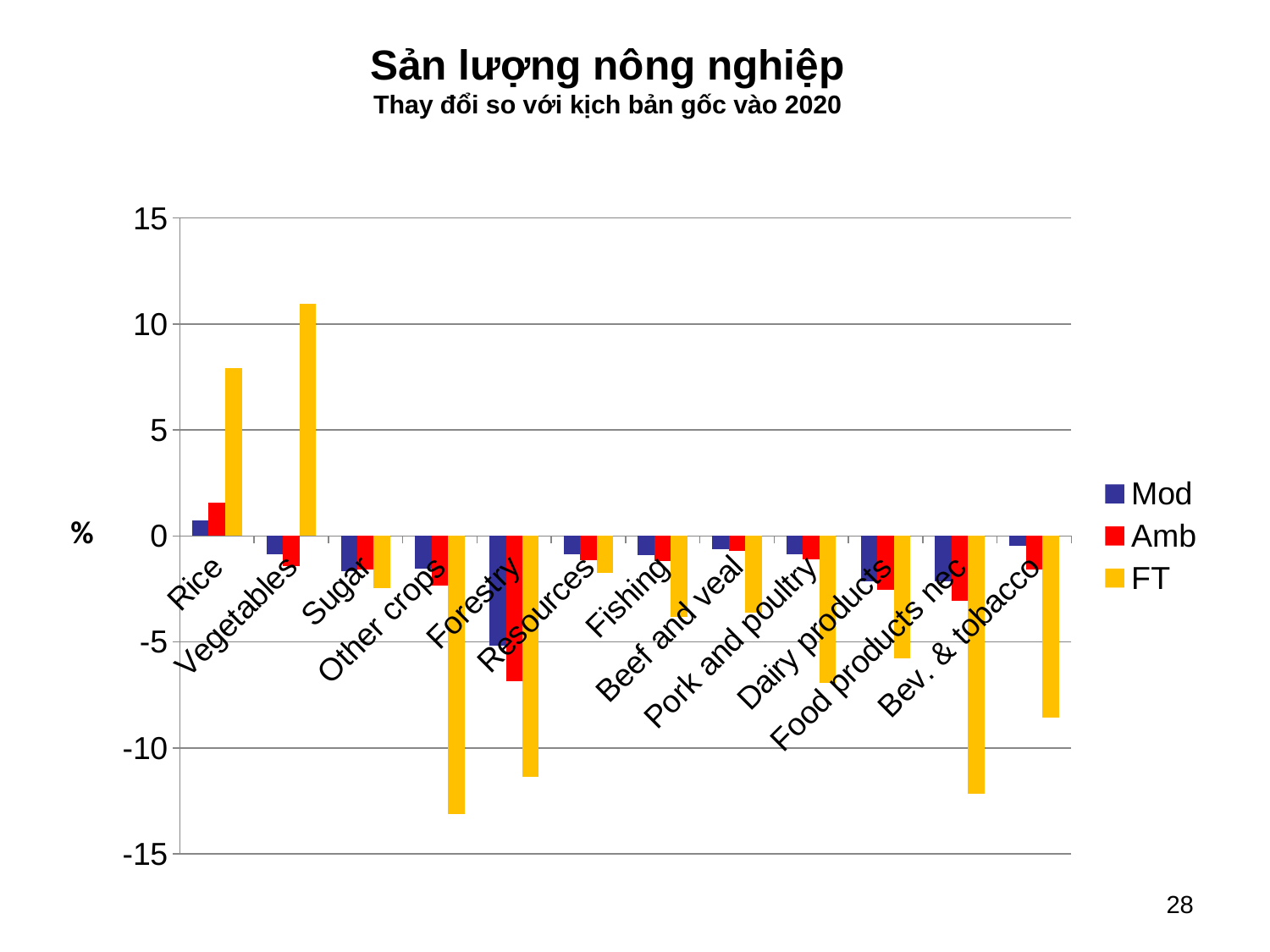
Which is larger, the FT value for Rice or the FT value for Vegetables? Vegetables Which category has the highest FT value? Vegetables Is the FT value for Vegetables greater or less than 10? greater How many series does the legend list? 3 How many categories are shown on the x axis of the chart? 12 What kind of chart is shown on the slide? bar chart Which category has the lowest Mod value? Forestry Is the Amb value for Forestry greater or less than -5? less Is the FT value for Rice greater or less than 5? greater Which category has the lowest Amb value? Forestry What is the label on the y axis of the chart? %